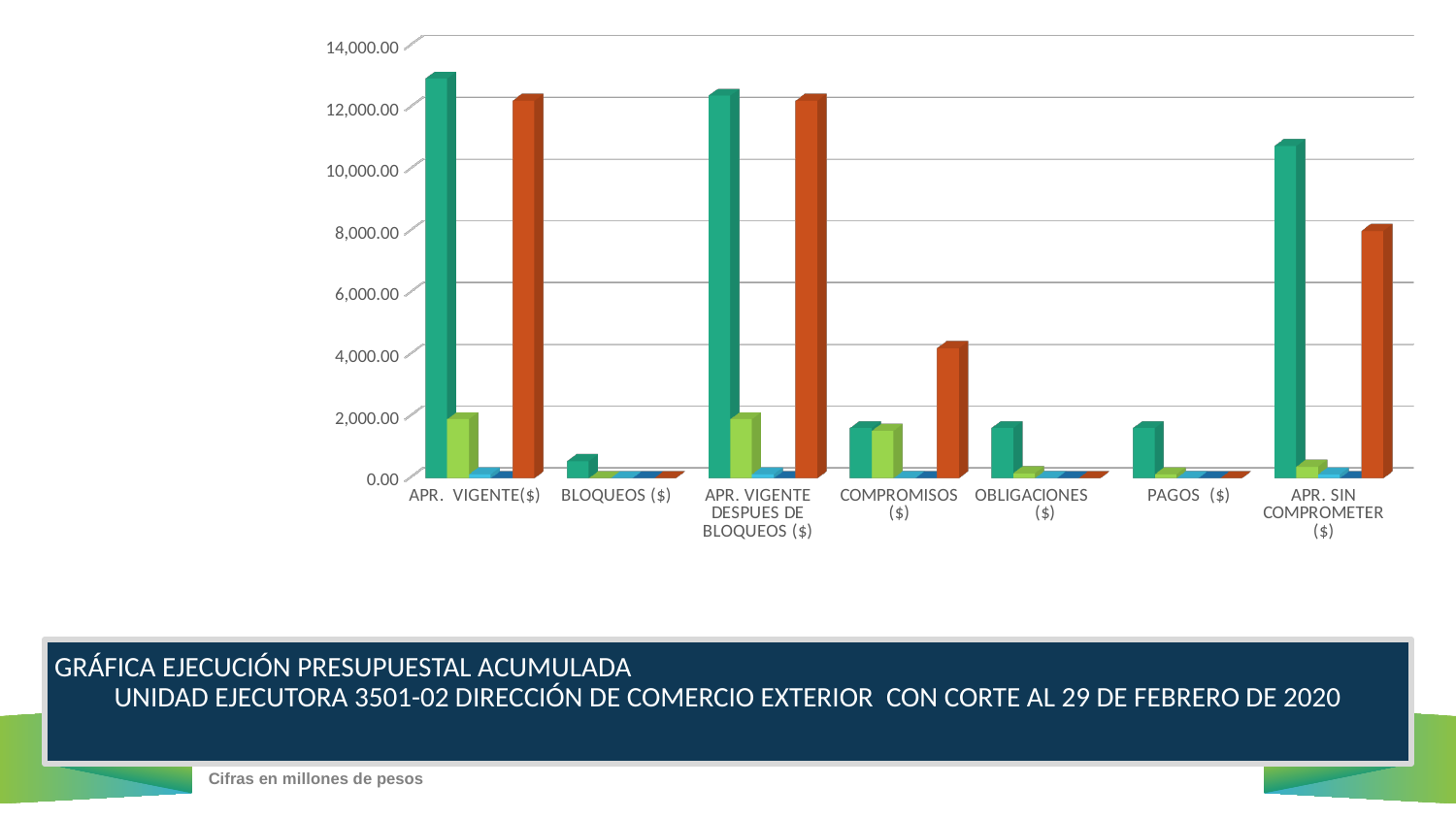
Is the value of the teal bar for BLOQUEOS ($) greater or less than 2,000.00? less Which category has the lowest teal bar? BLOQUEOS ($) What is the highest value shown on the vertical axis of the chart? 14,000.00 How many categories are shown along the x axis of the chart? 7 Is the value of the orange bar for APR. SIN COMPROMETER ($) greater or less than 10,000.00? less According to the note on the slide, in what units are the chart figures expressed? millones de pesos For APR. SIN COMPROMETER ($), which is larger: the teal bar or the orange bar? the teal bar Is the value of the orange bar for COMPROMISOS ($) greater or less than 2,000.00? greater What kind of chart is shown on the slide? bar chart For COMPROMISOS ($), which is larger: the teal bar or the orange bar? the orange bar